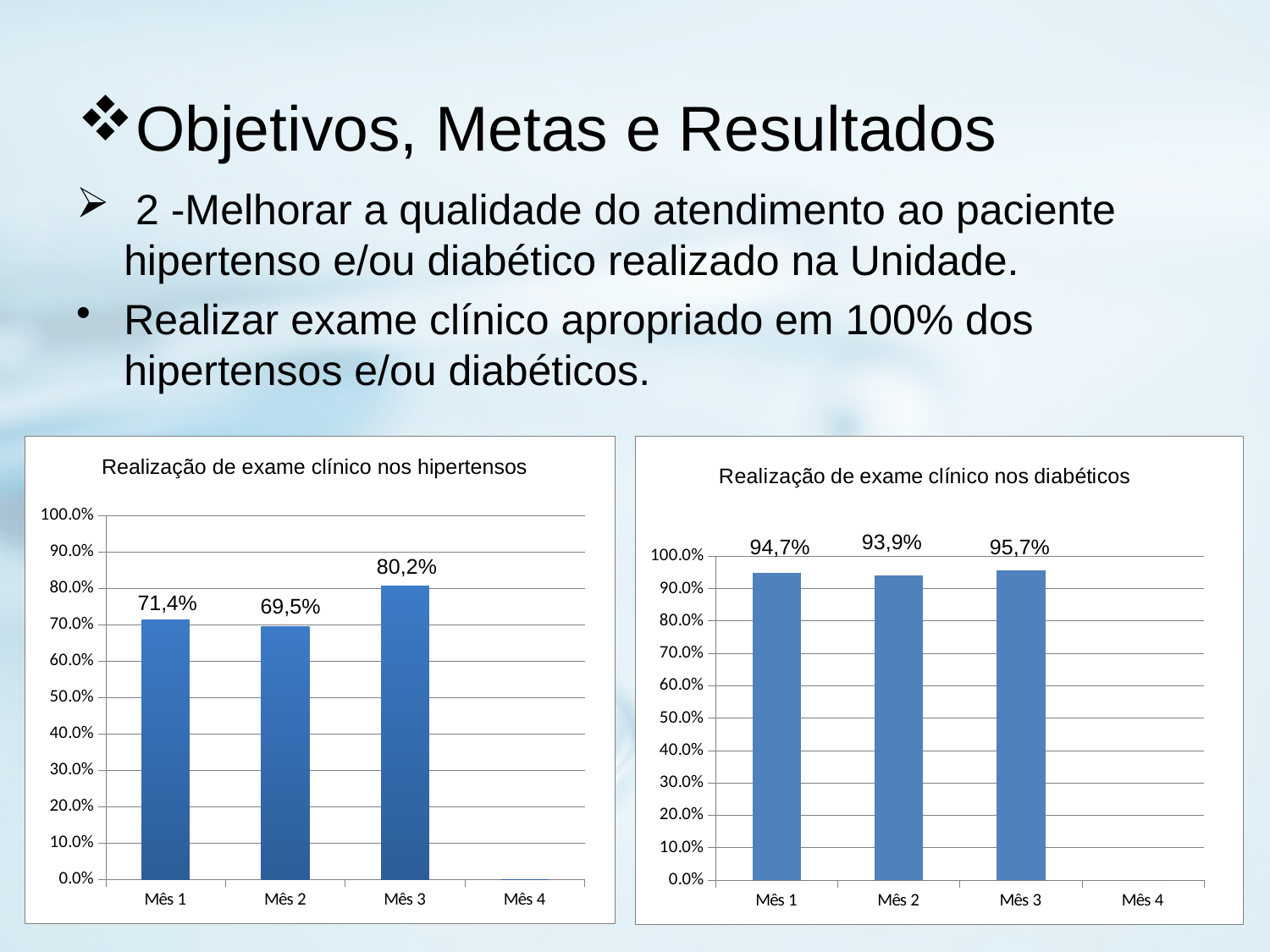
In the chart 'Realização de exame clínico nos diabéticos', what is the difference between the values for Mês 3 and Mês 2? 1,8% In the chart 'Realização de exame clínico nos diabéticos', which month has the highest value? Mês 3 In the chart 'Realização de exame clínico nos hipertensos', what is the value for Mês 3? 80,2% In the chart 'Realização de exame clínico nos hipertensos', which is larger, the value for Mês 1 or Mês 2? Mês 1 How many bars are plotted in the chart 'Realização de exame clínico nos diabéticos'? 3 What kind of chart is the chart on the left of the slide? Bar chart In the chart 'Realização de exame clínico nos hipertensos', what is the difference between the values for Mês 3 and Mês 2? 10,7% In the chart 'Realização de exame clínico nos hipertensos', is the value for Mês 3 greater or less than 70.0%? greater In the chart 'Realização de exame clínico nos diabéticos', what is the value for Mês 2? 93,9% In the chart 'Realização de exame clínico nos diabéticos', what is the value for Mês 3? 95,7% In the chart 'Realização de exame clínico nos hipertensos', what is the value for Mês 1? 71,4%